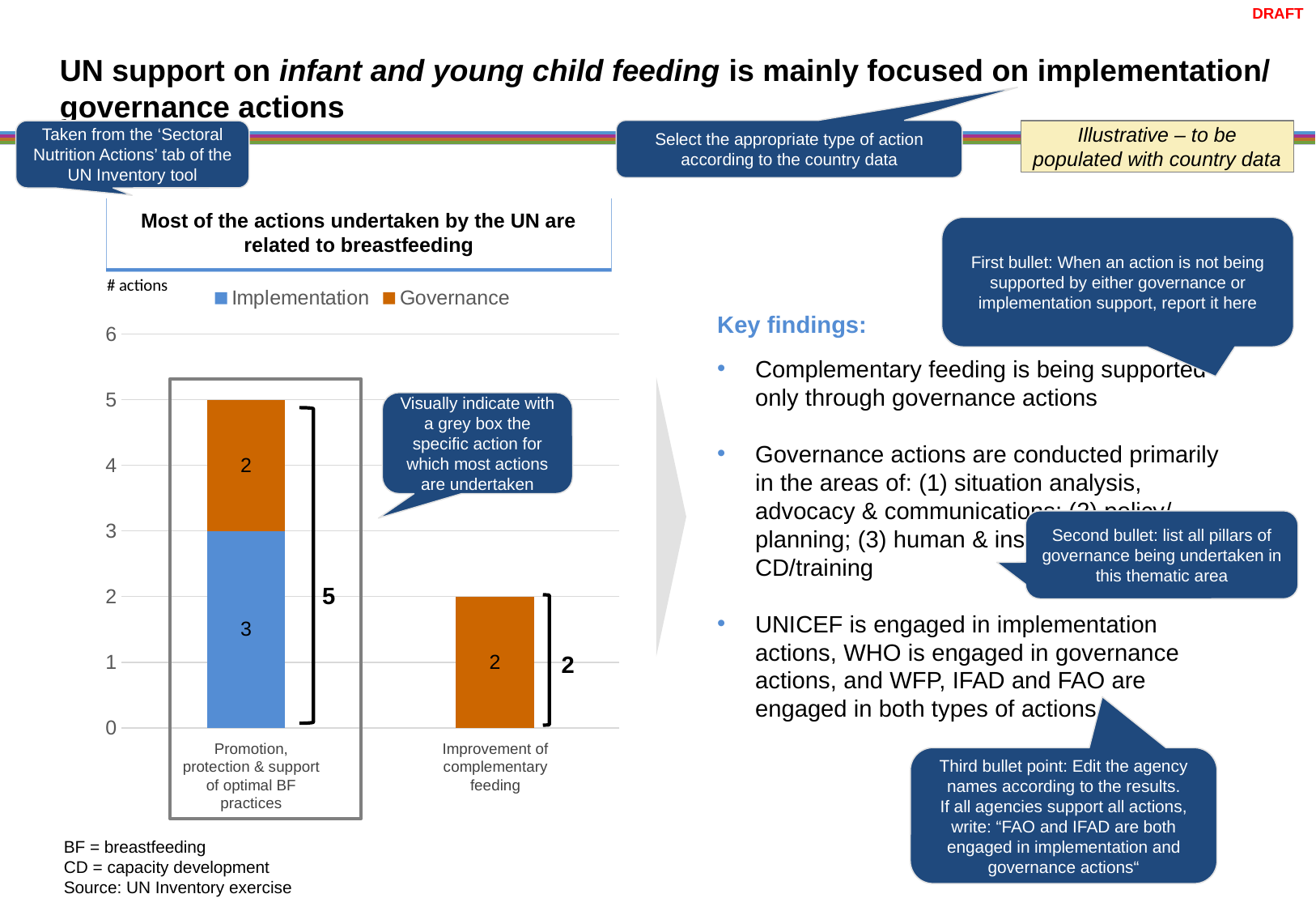
What type of chart is shown on the slide? Stacked bar chart What is the total number of actions for 'Improvement of complementary feeding'? 2 How many series does the chart legend list? 2 What is the Governance value for 'Promotion, protection & support of optimal BF practices'? 2 What is the Governance value for 'Improvement of complementary feeding'? 2 What is the title of the chart? Most of the actions undertaken by the UN are related to breastfeeding Which category has the highest total number of actions? Promotion, protection & support of optimal BF practices How many categories are shown on the x axis of the chart? 2 What is the difference between the total actions for 'Promotion, protection & support of optimal BF practices' and 'Improvement of complementary feeding'? 3 Which is larger for 'Promotion, protection & support of optimal BF practices': the Implementation value or the Governance value? Implementation What is the Implementation value for 'Promotion, protection & support of optimal BF practices'? 3 What is the total number of actions for 'Promotion, protection & support of optimal BF practices'? 5